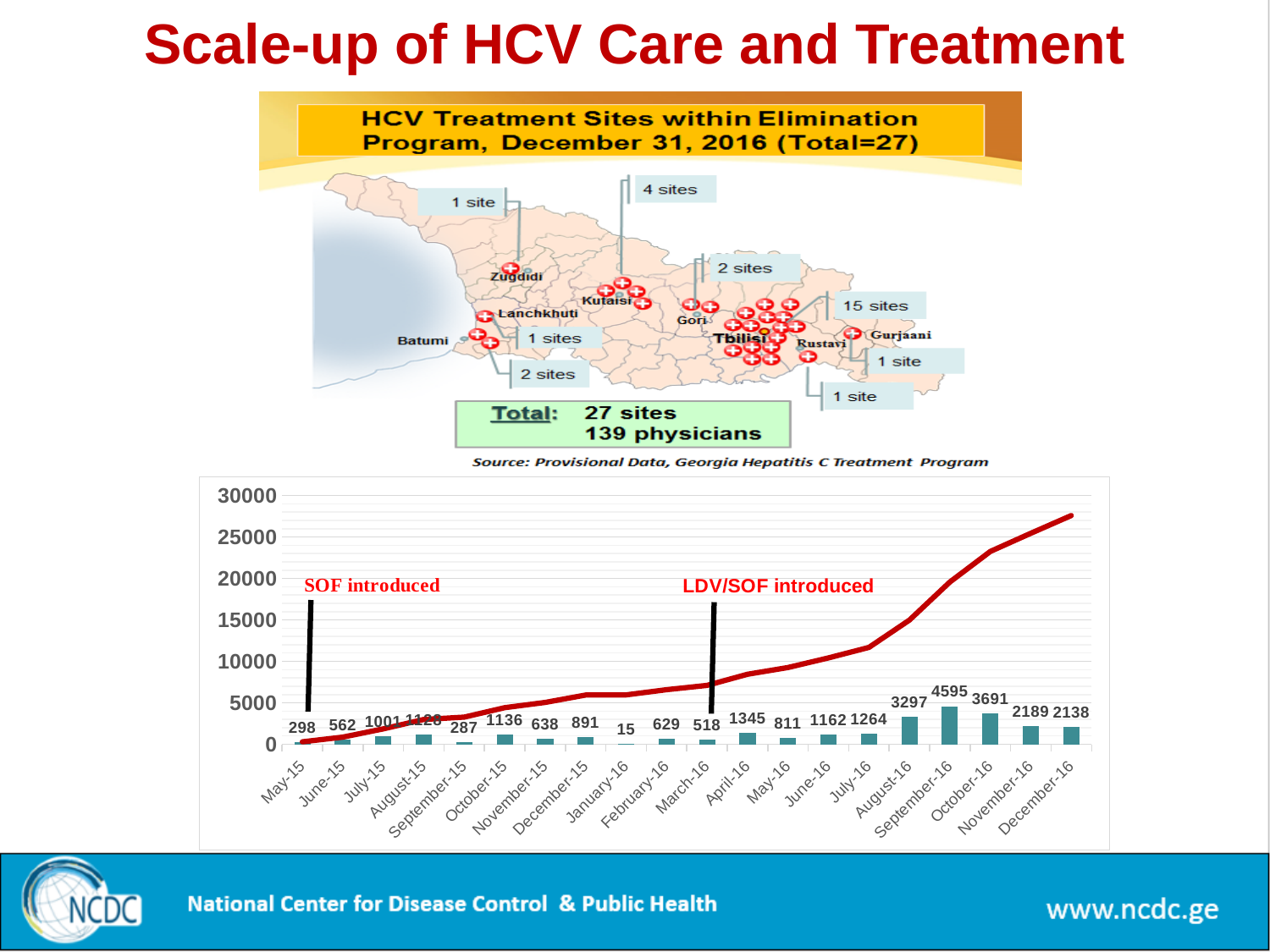
In the bar-and-line chart at the bottom of the slide, what is the bar value for September-16? 4595 In the bar-and-line chart at the bottom of the slide, is the value of the red line at December-16 greater or less than 25000? greater In the bar-and-line chart at the bottom of the slide, what is the bar value for May-15? 298 In the bar-and-line chart at the bottom of the slide, is the value of the red line at March-16 greater or less than 10000? less In the bar-and-line chart at the bottom of the slide, which month has the lowest bar value? January-16 How many months are shown on the x axis of the bar-and-line chart at the bottom of the slide? 20 In the bar-and-line chart at the bottom of the slide, does the red line rise or fall from May-15 to December-16? rise In the bar-and-line chart at the bottom of the slide, which has the larger bar value, April-16 or May-16? April-16 In the bar-and-line chart at the bottom of the slide, what event is annotated at the vertical marker near March-16? LDV/SOF introduced In the bar-and-line chart at the bottom of the slide, what is the difference between the bar values for September-16 and October-16? 904 In the bar-and-line chart at the bottom of the slide, what is the bar value for April-16? 1345 In the bar-and-line chart at the bottom of the slide, which month has the highest bar value? September-16